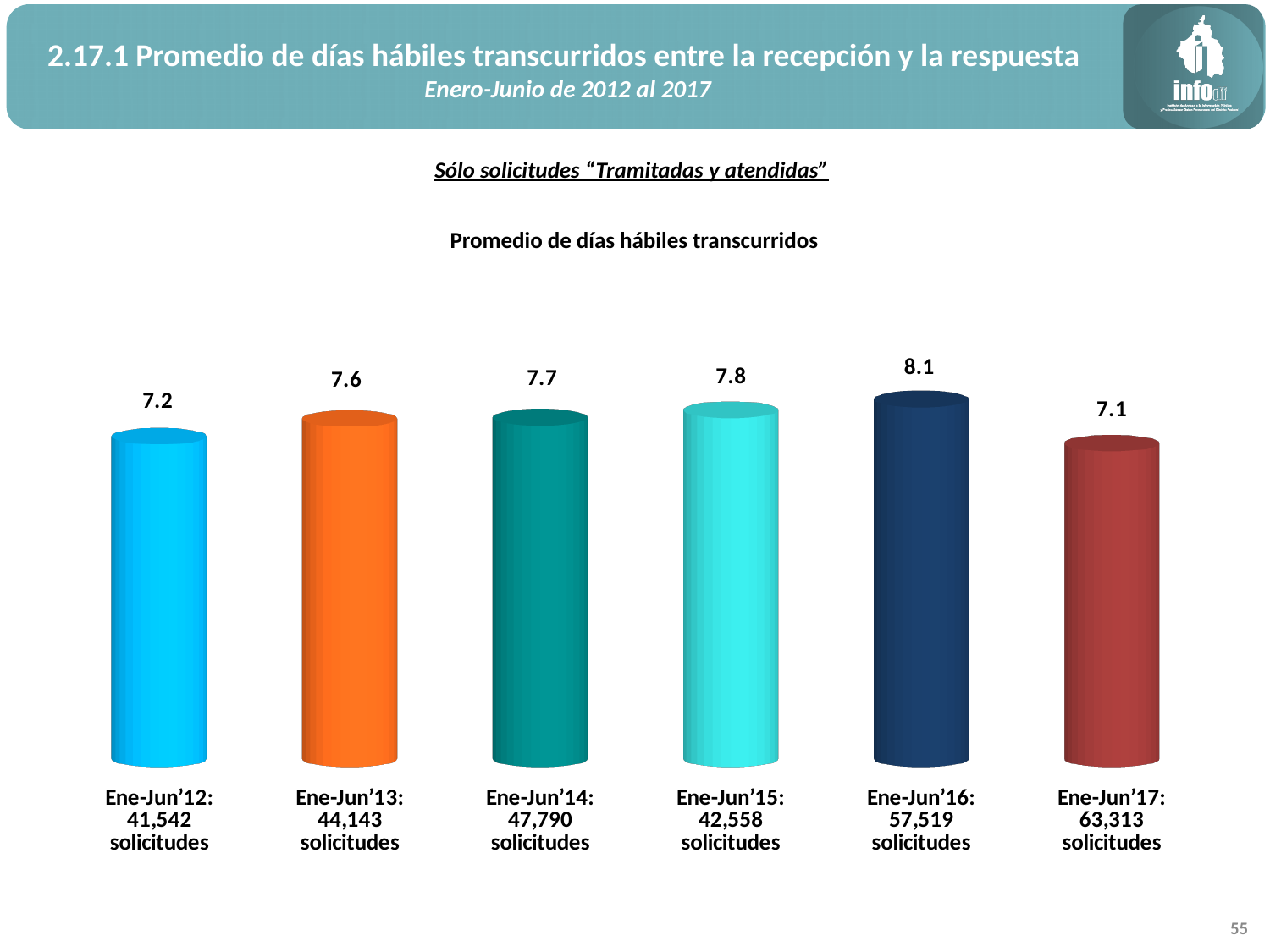
What is the average number of business days elapsed for Ene-Jun'12? 7.2 Do the values rise or fall from Ene-Jun'12 to Ene-Jun'16? Rise What is the value shown for Ene-Jun'17? 7.1 What is the difference between the values for Ene-Jun'16 and Ene-Jun'17? 1.0 Which period has the highest average number of business days elapsed? Ene-Jun'16 What kind of chart is shown on the slide? Bar chart Which is larger, the value for Ene-Jun'13 or the value for Ene-Jun'17? Ene-Jun'13 What is the value shown for Ene-Jun'16? 8.1 How many periods are shown in the chart? 6 How many solicitudes are indicated for Ene-Jun'17 in the category label? 63,313 Which period has the lowest average number of business days elapsed? Ene-Jun'17 What is the difference between the values for Ene-Jun'15 and Ene-Jun'12? 0.6